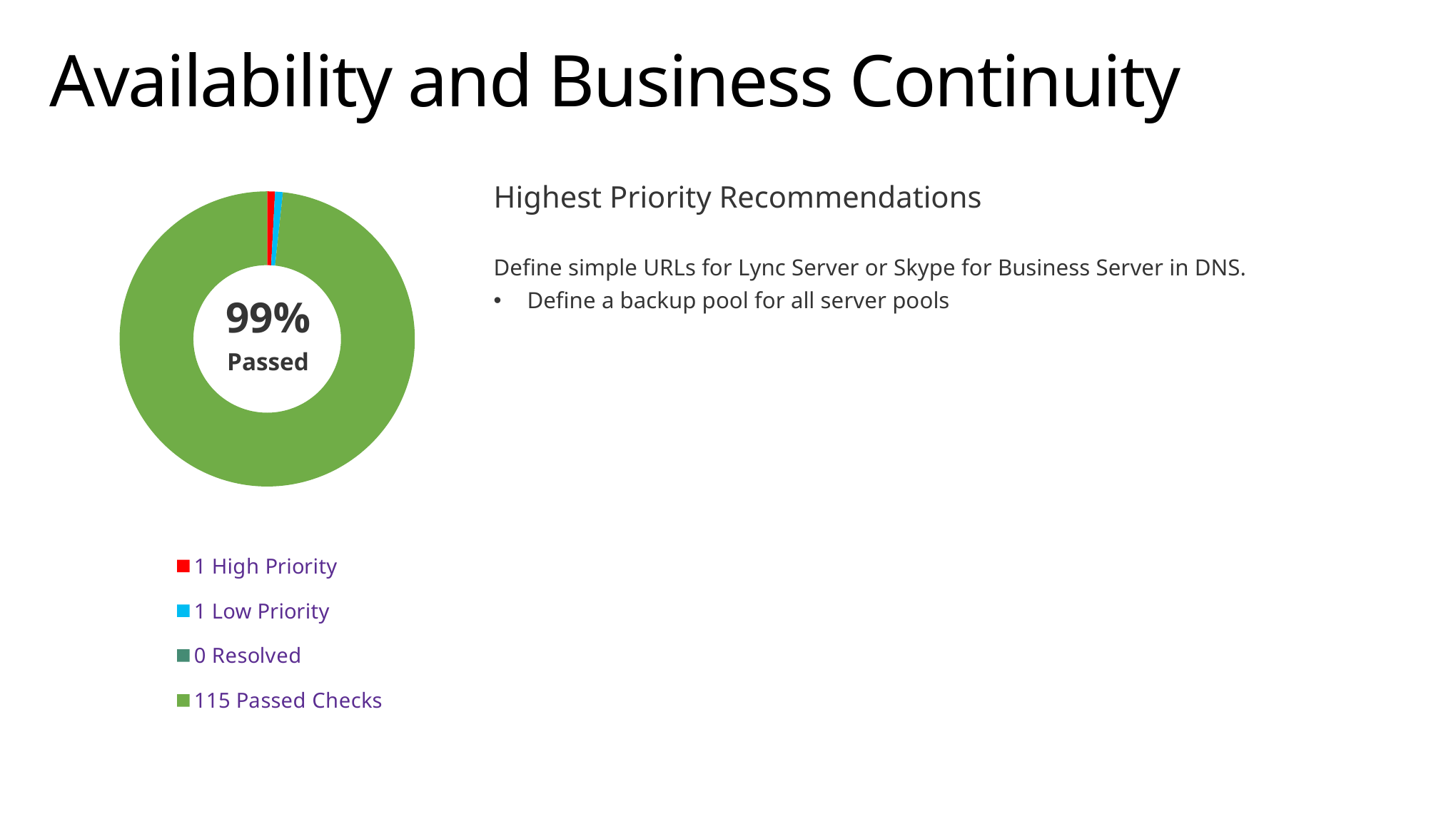
How many passed checks does the chart's legend report? 115 How many resolved items does the chart's legend report? 0 What percentage is shown in the centre of the doughnut chart? 99% How many categories does the chart's legend list? 4 How many high priority items does the chart's legend report? 1 What is the difference between the number of passed checks and the number of high priority items? 114 Which category has the largest value in the chart? Passed Checks Which category has the smallest value in the chart? Resolved How many low priority items does the chart's legend report? 1 Which is larger, the number of passed checks or the number of low priority items? Passed Checks What is the total of all the values listed in the chart's legend? 117 What kind of chart is shown on the slide? doughnut chart